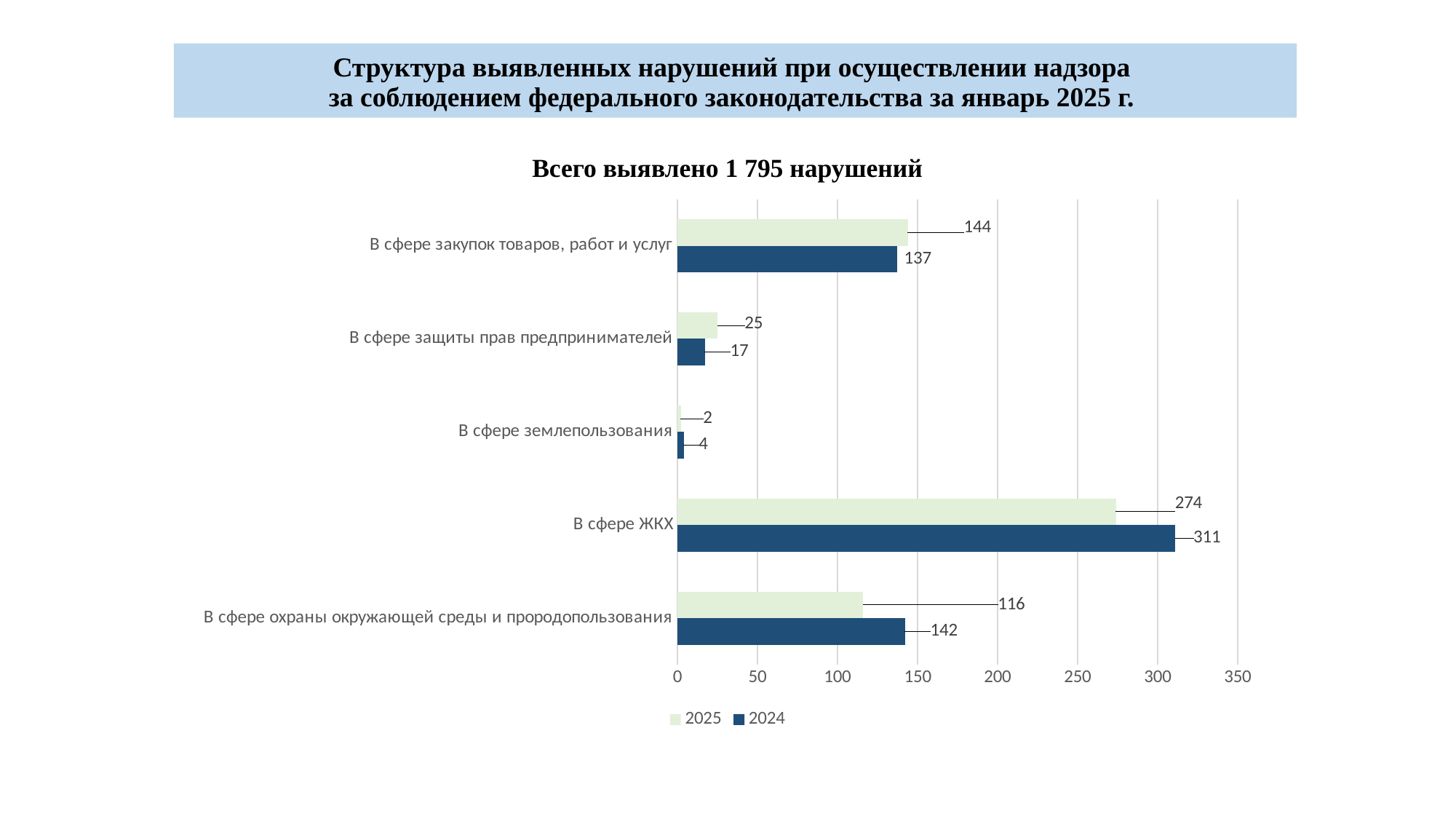
What is the 2025 value for «В сфере ЖКХ»? 274 Which category has the highest 2024 value? В сфере ЖКХ What total number of violations is stated above the chart? 1 795 Which category has the lowest 2025 value? В сфере землепользования How many categories are shown on the chart? 5 What is the 2025 value for «В сфере охраны окружающей среды и прородопользования»? 116 What is the difference between the 2024 and 2025 values for «В сфере ЖКХ»? 37 What kind of chart is shown on the slide? Bar chart What is the 2024 value for «В сфере закупок товаров, работ и услуг»? 137 How many series does the legend list? 2 What is the 2024 value for «В сфере защиты прав предпринимателей»? 17 Which is larger for «В сфере охраны окружающей среды и прородопользования»: the 2024 value or the 2025 value? 2024